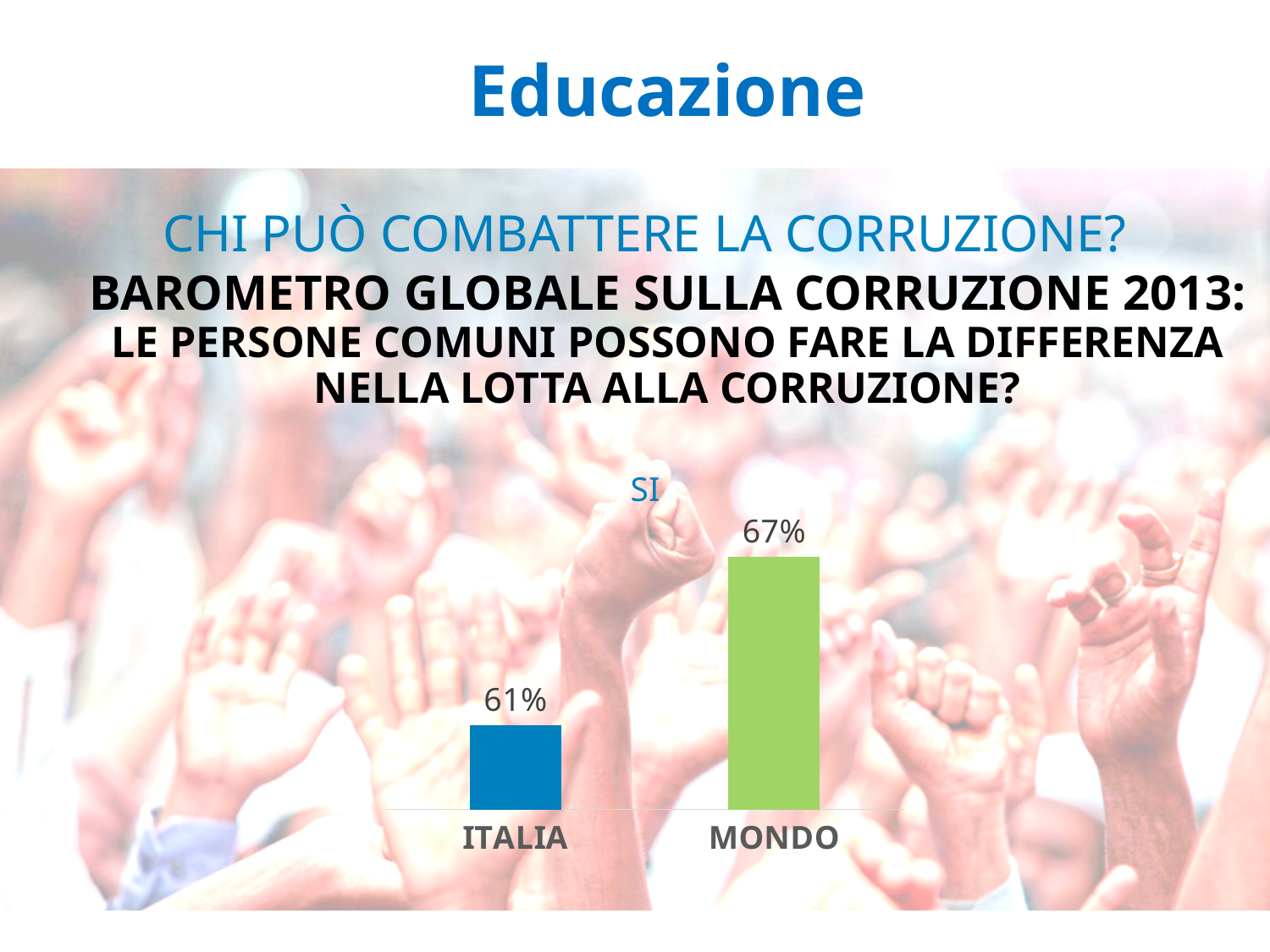
What kind of chart is shown on the slide? bar chart What colour is the bar for ITALIA? blue What is the title of the chart? SI What is the value for MONDO? 67% What is the difference between the values for MONDO and ITALIA? 6% Which category has the highest value? MONDO What is the value for ITALIA? 61% Which category has the lowest value? ITALIA How many categories are shown in the chart? 2 Which is larger, the value for ITALIA or the value for MONDO? MONDO